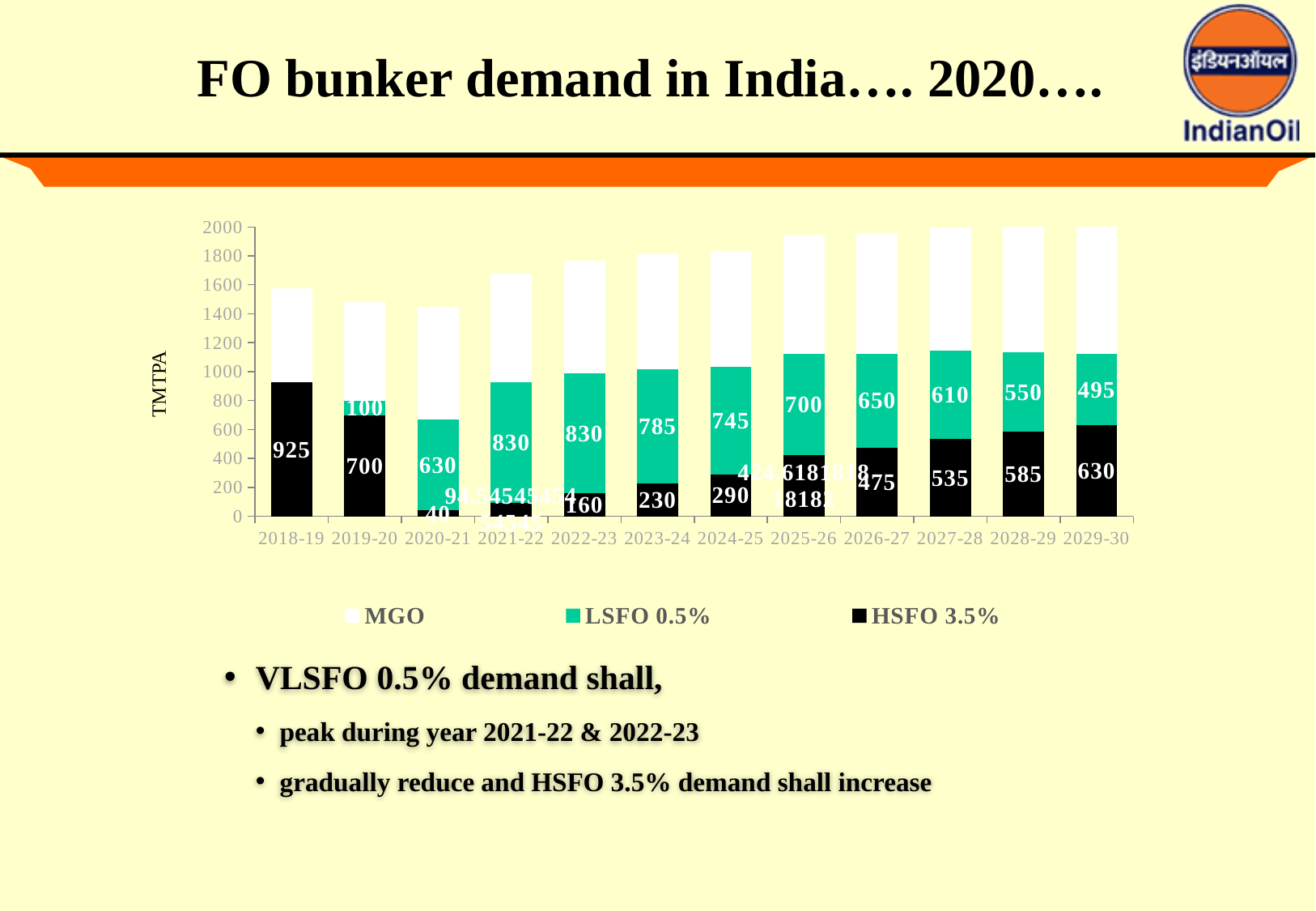
How many years are shown on the x axis? 12 What is the LSFO 0.5% value for 2029-30? 495 What is the difference between the LSFO 0.5% value for 2022-23 and for 2029-30? 335 What is the HSFO 3.5% value for 2018-19? 925 What is the LSFO 0.5% value for 2023-24? 785 What kind of chart is shown on the slide? stacked bar chart How many series does the legend list? 3 Do the LSFO 0.5% values rise or fall from 2022-23 to 2029-30? fall Which year has the lowest HSFO 3.5% value? 2020-21 Which year has the highest HSFO 3.5% value? 2018-19 Is the total height of the stacked bar for 2029-30 greater or less than 1800? greater Which is larger, the HSFO 3.5% value for 2019-20 or for 2029-30? 2019-20